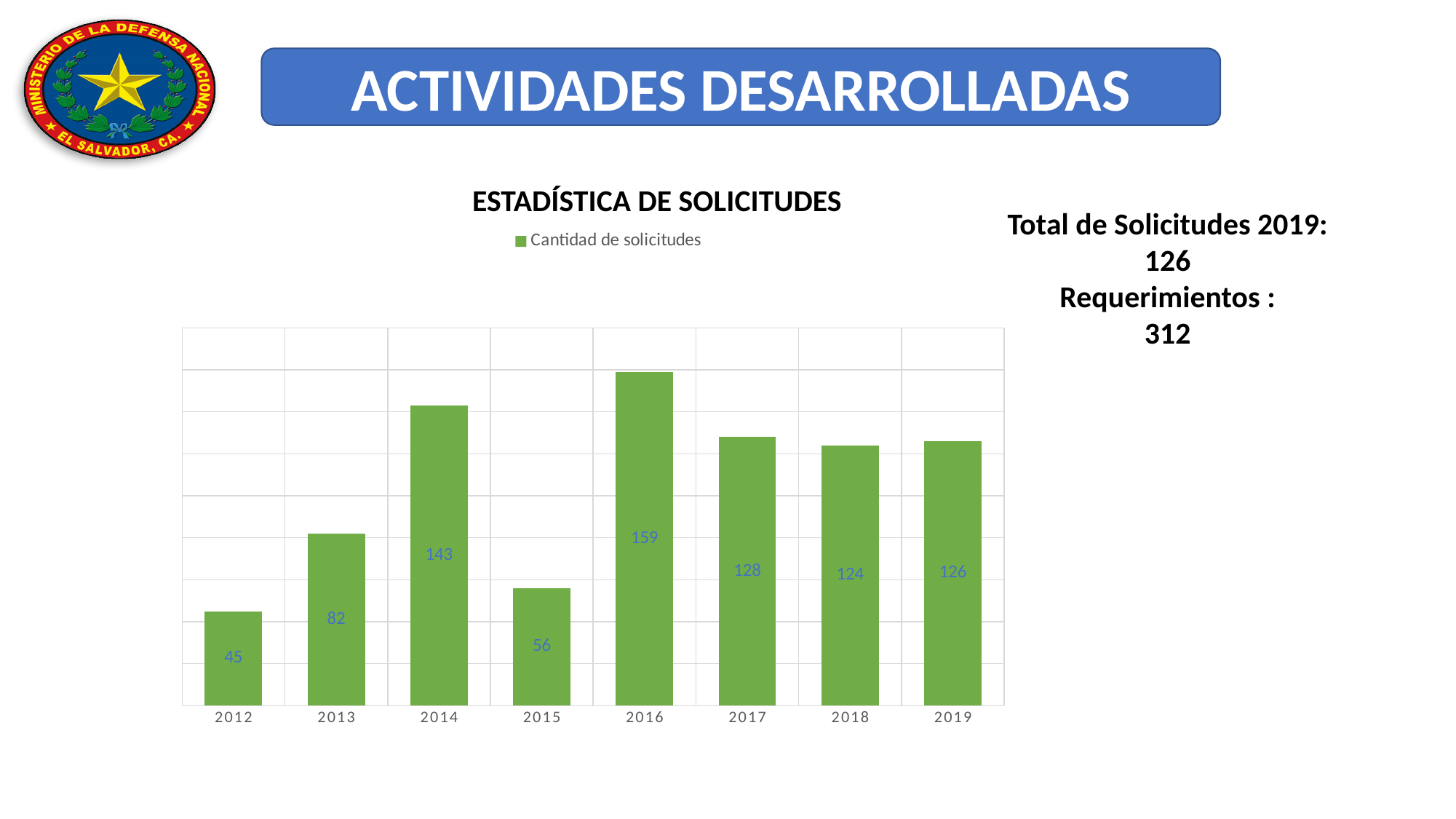
What is the title of the chart? ESTADÍSTICA DE SOLICITUDES How many years are shown on the x axis of the chart? 8 Which year has the highest number of solicitudes? 2016 What is the value for 2014 in the chart? 143 What is the difference between the values for 2016 and 2015? 103 What is the value for 2012 in the chart? 45 Which year has the lowest number of solicitudes? 2012 What is the value for 2016 in the chart? 159 What is the difference between the values for 2019 and 2018? 2 Which is larger, the value for 2013 or the value for 2015? 2013 How many series does the legend list? 1 What kind of chart is shown on the slide? bar chart